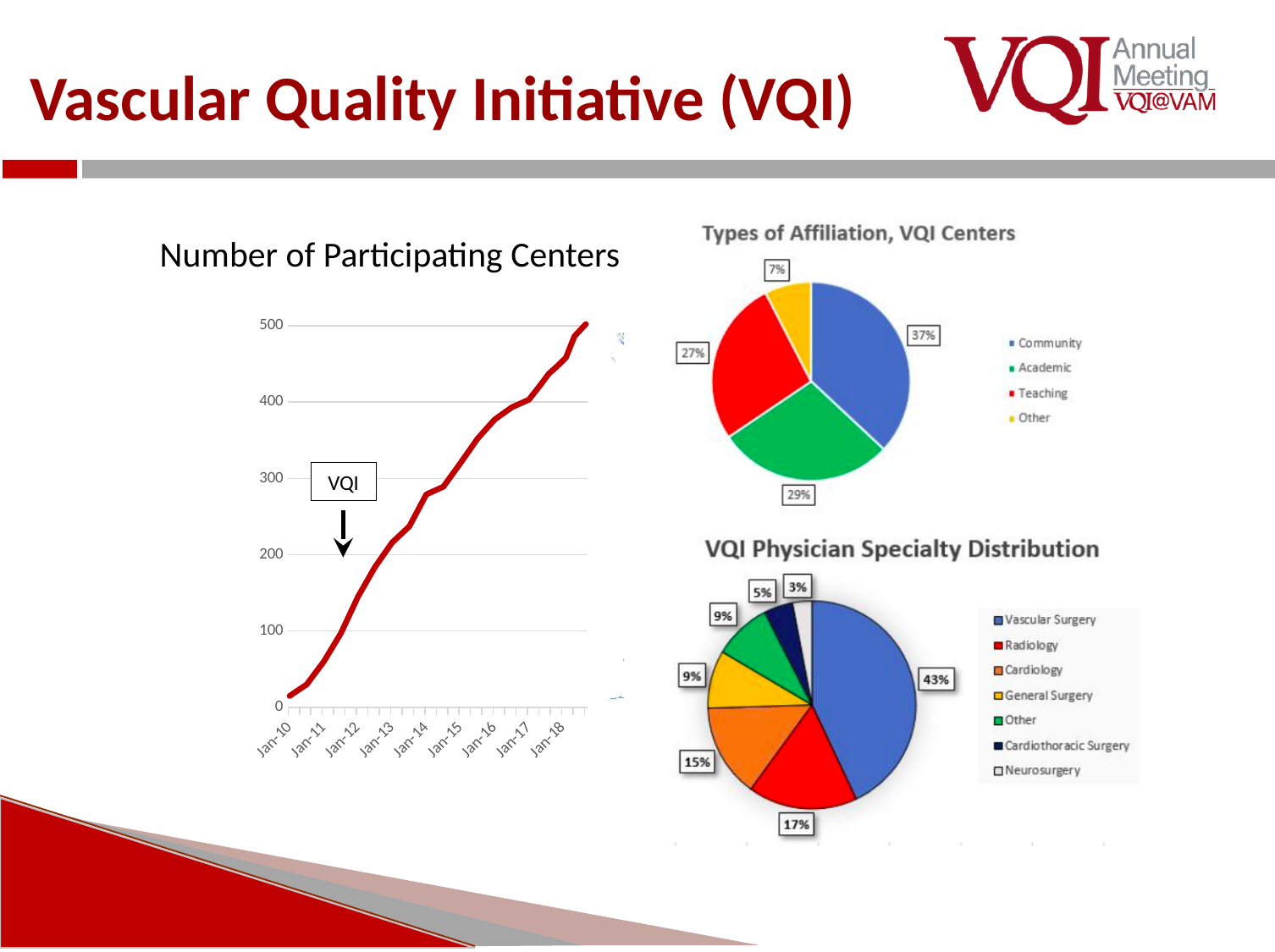
In the 'Number of Participating Centers' chart, is the value at Jan-12 greater or less than 200? less In the 'VQI Physician Specialty Distribution' pie chart, how many specialties does the legend list? 7 In the 'Types of Affiliation, VQI Centers' pie chart, how many categories does the legend list? 4 In the 'VQI Physician Specialty Distribution' pie chart, what share is Vascular Surgery? 43% In the 'Types of Affiliation, VQI Centers' pie chart, what share is Community? 37% What kind of chart is the 'Number of Participating Centers' chart? line chart In the 'Types of Affiliation, VQI Centers' pie chart, which category has the smallest share? Other In the 'Number of Participating Centers' chart, is the value at Jan-16 greater or less than 300? greater In the 'Types of Affiliation, VQI Centers' pie chart, what share is Teaching? 27% In the 'Number of Participating Centers' chart, do the values rise or fall from Jan-10 to Jan-18? rise In the 'VQI Physician Specialty Distribution' pie chart, which specialty has the smallest share? Neurosurgery In the 'VQI Physician Specialty Distribution' pie chart, what is the difference between the Radiology and Cardiology shares? 2%